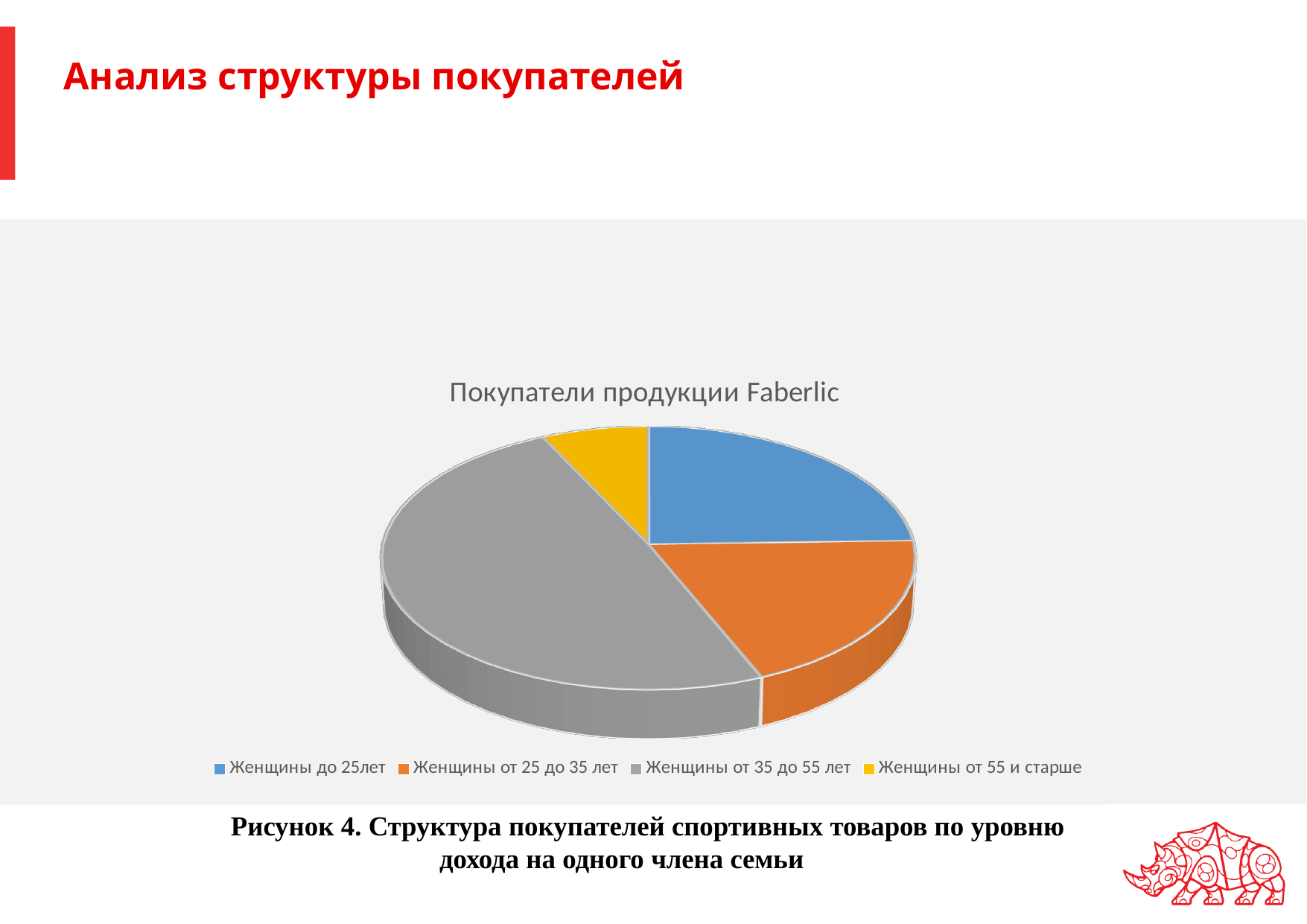
Which category has the largest share of the pie? Женщины от 35 до 55 лет What colour is the slice for Женщины от 35 до 55 лет? gray Which slice is larger: Женщины до 25лет or Женщины от 55 и старше? Женщины до 25лет Which slice is larger: Женщины от 25 до 35 лет or Женщины от 55 и старше? Женщины от 25 до 35 лет Which category has the smallest share of the pie? Женщины от 55 и старше How many categories (slices) does the pie chart have? 4 What kind of chart is shown on the slide? pie chart What is the title of the chart? Покупатели продукции Faberlic Which slice is larger: Женщины от 35 до 55 лет or Женщины от 25 до 35 лет? Женщины от 35 до 55 лет